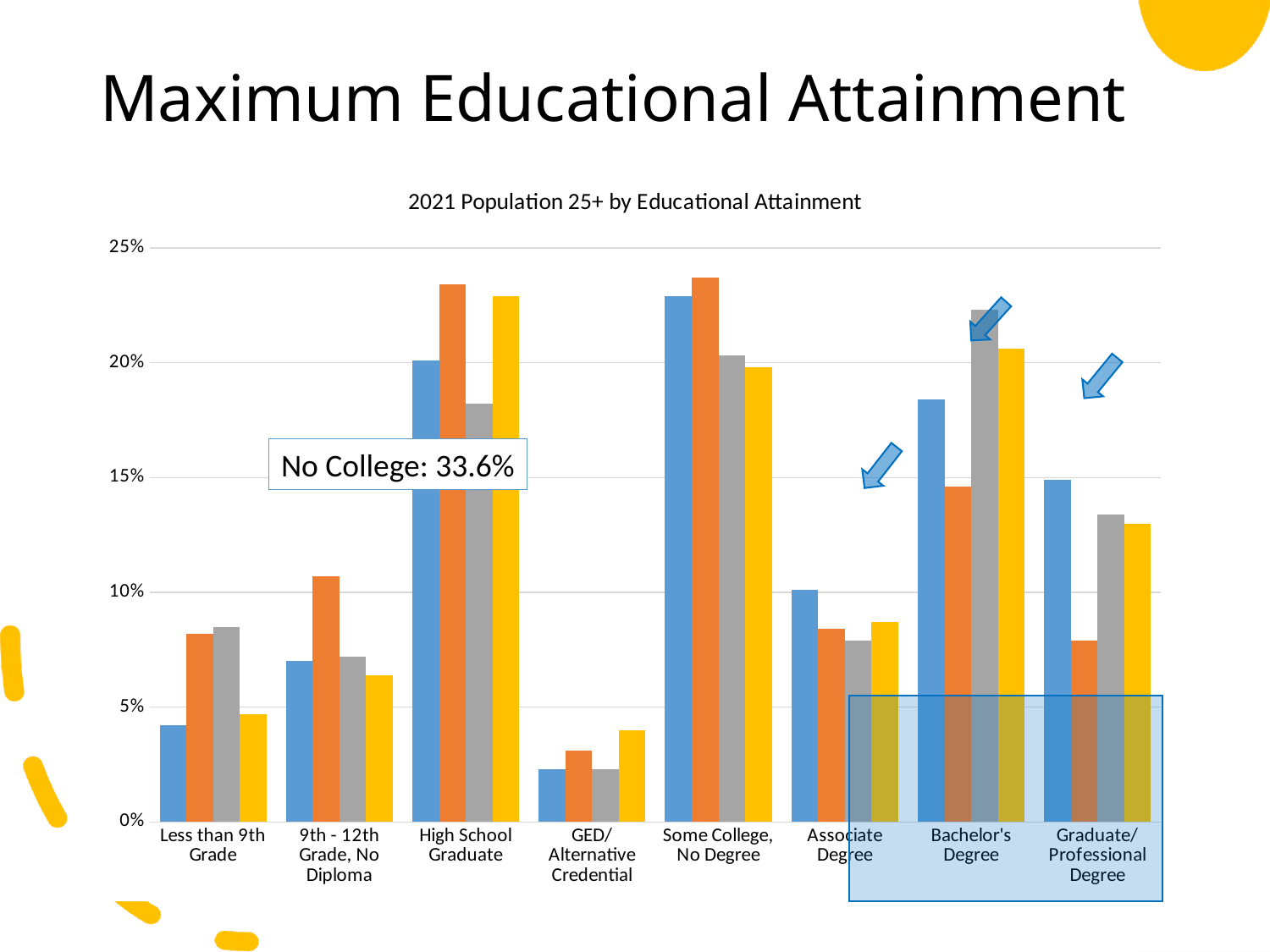
Is the value of the blue bar for Some College, No Degree greater or less than 20%? greater Is the value of the orange bar for GED/Alternative Credential greater or less than 5%? less Among the blue bars, which category has the lowest value? GED/Alternative Credential What is the title of the chart? 2021 Population 25+ by Educational Attainment Is the value of the gray bar for Bachelor's Degree greater or less than 20%? greater How many bars are plotted for each educational attainment category? 4 What kind of chart is shown on the slide? bar chart Among the gray bars, which category has the highest value? Bachelor's Degree What percentage does the text box on the chart give for "No College"? 33.6% How many educational attainment categories are shown on the x axis? 8 For Graduate/Professional Degree, which is larger: the blue bar or the orange bar? the blue bar